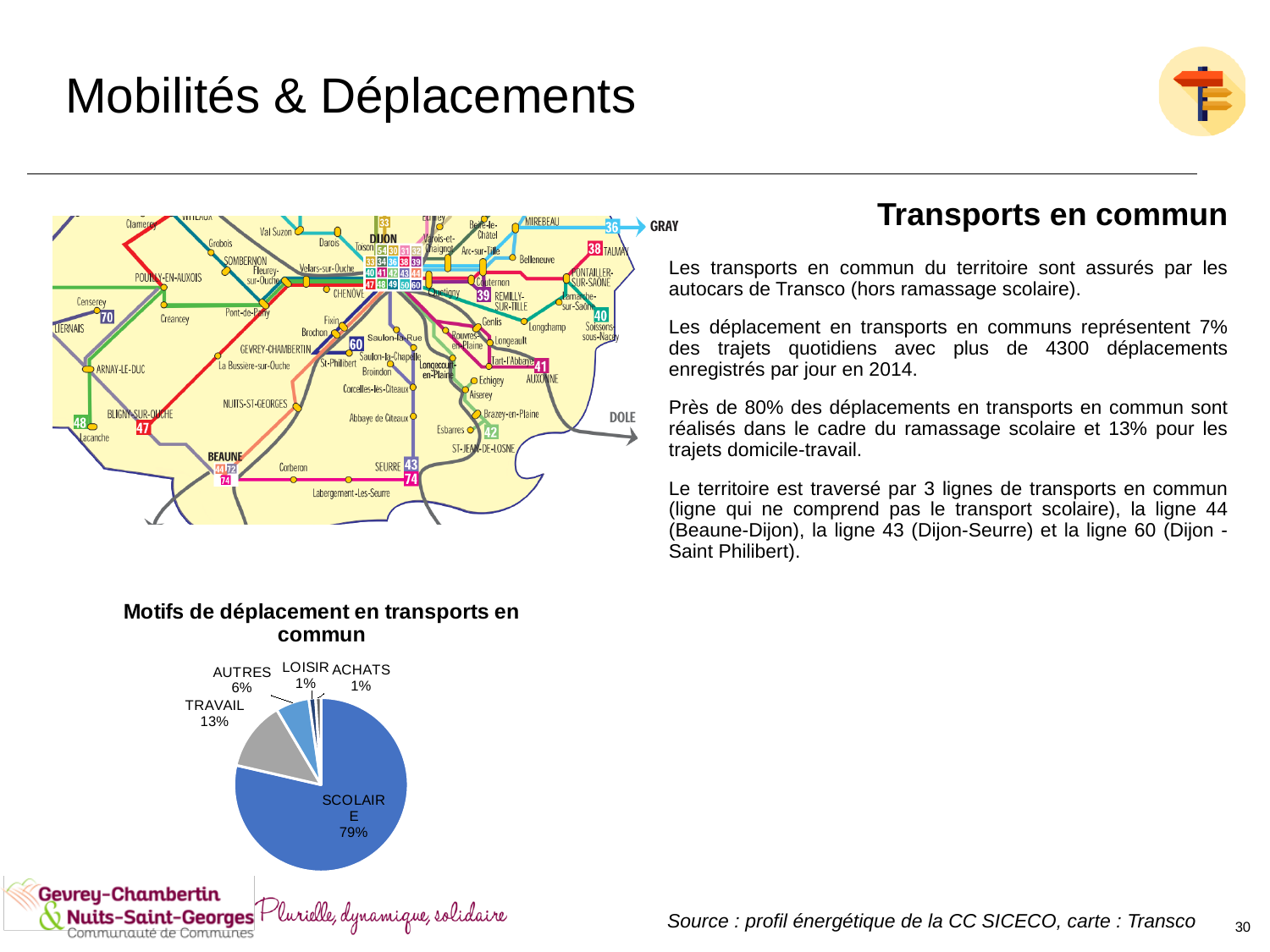
What share of the pie chart does LOISIR represent? 1% What is the title of the pie chart on the slide? Motifs de déplacement en transports en commun Which category has the largest slice in the pie chart? SCOLAIRE What share of the pie chart does TRAVAIL represent? 13% What is the difference in percentage points between SCOLAIRE and TRAVAIL in the pie chart? 66 What share of the pie chart does SCOLAIRE represent? 79% What is the difference in percentage points between TRAVAIL and AUTRES in the pie chart? 7 What type of chart is 'Motifs de déplacement en transports en commun'? pie chart How many slices does the pie chart have? 5 Which is larger in the pie chart, TRAVAIL or AUTRES? TRAVAIL